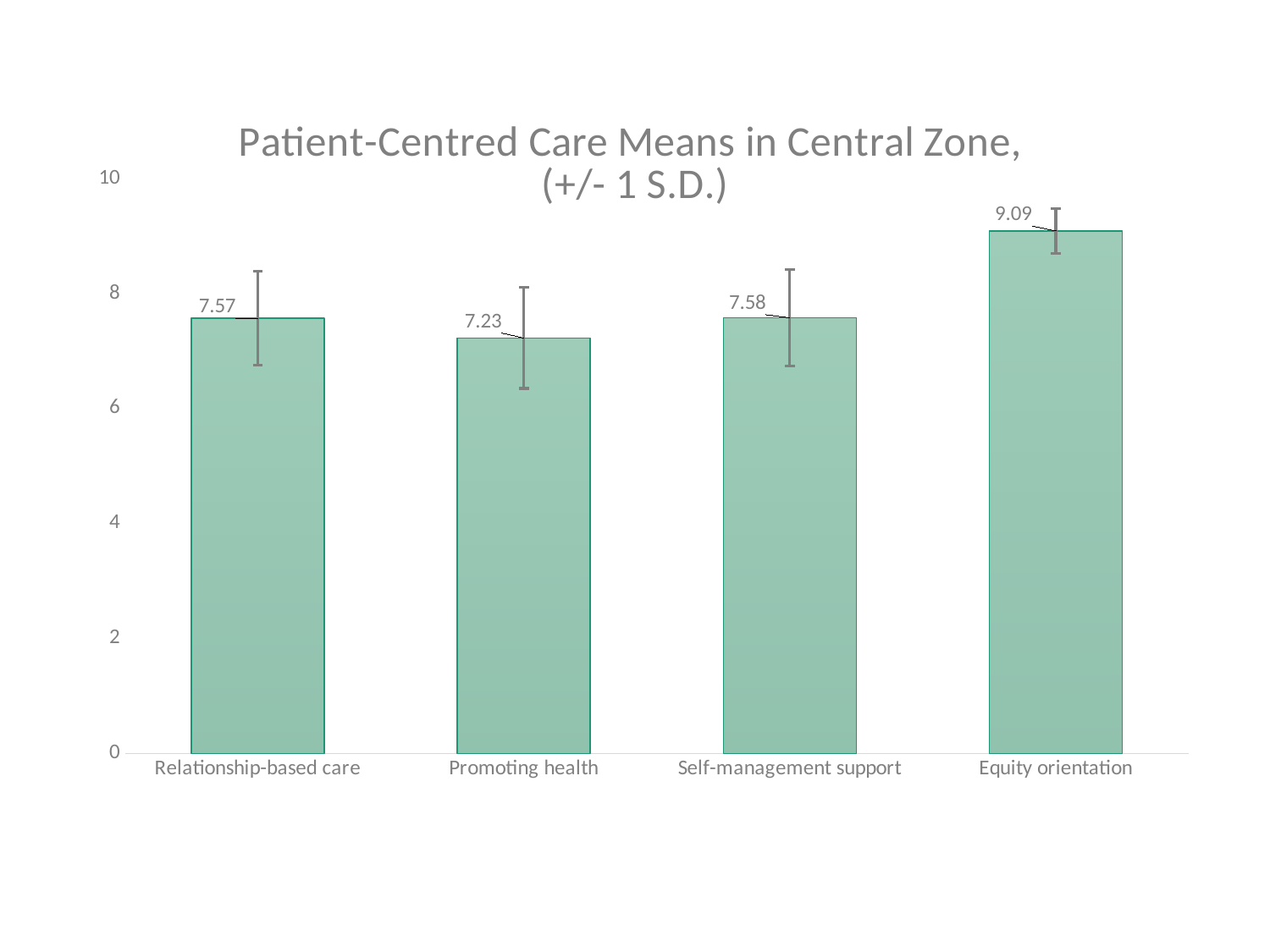
What kind of chart is this? Bar chart Is the value for Equity orientation greater or less than 8? greater What is the mean value for Promoting health? 7.23 Which has a larger mean, Equity orientation or Relationship-based care? Equity orientation What is the mean value for Equity orientation? 9.09 Which category has the highest mean? Equity orientation What is the difference between the means for Equity orientation and Promoting health? 1.86 What is the mean value for Self-management support? 7.58 How many categories are shown on the chart? 4 What is the mean value for Relationship-based care? 7.57 What is the difference between the means for Relationship-based care and Promoting health? 0.34 Which category has the lowest mean? Promoting health